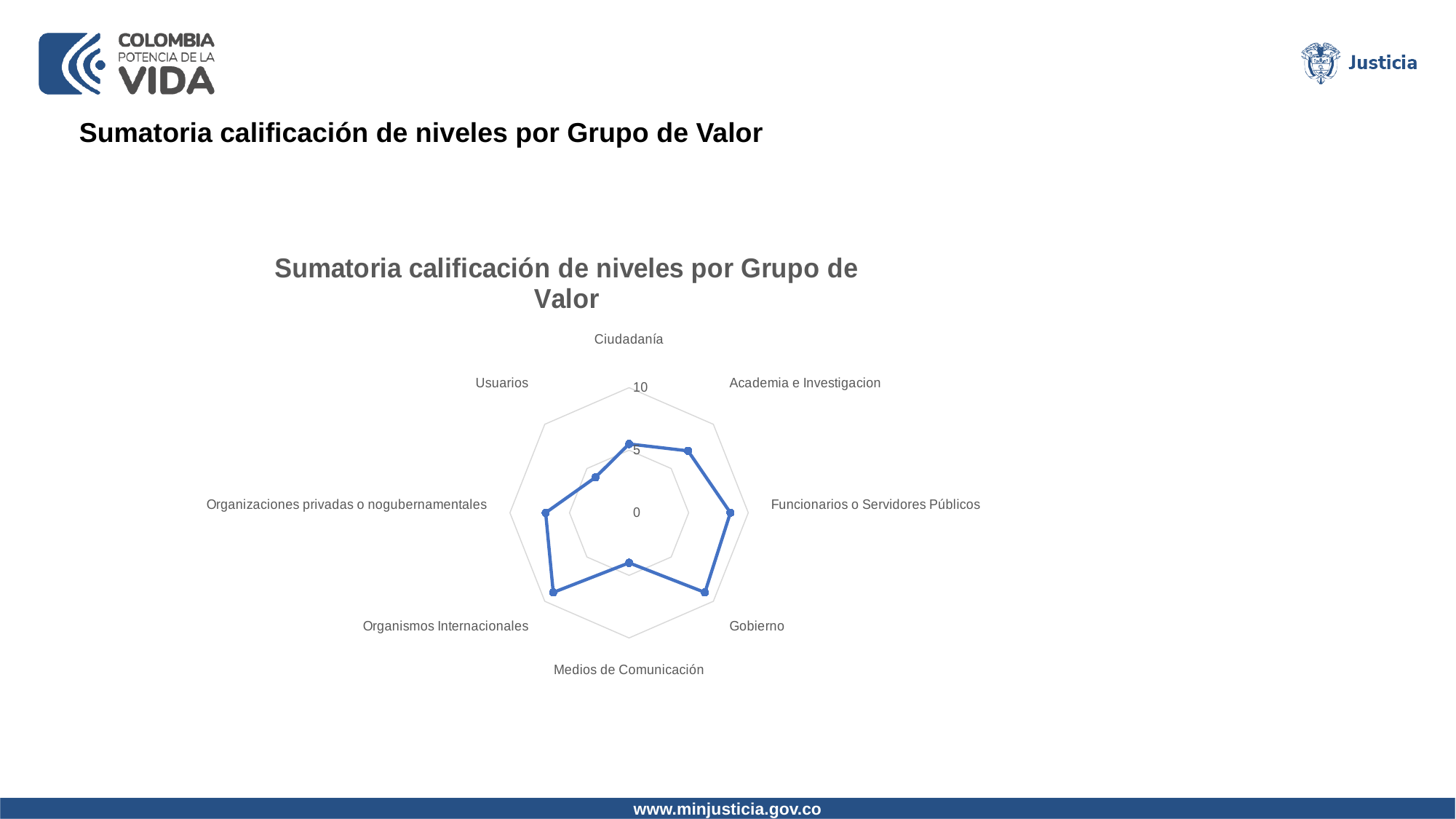
Is the value for Medios de Comunicación greater or less than 5? less Which has the larger value, Organismos Internacionales or Medios de Comunicación? Organismos Internacionales Is the value for Gobierno greater or less than 5? greater Is the value for Usuarios greater or less than 5? less What is the highest value shown on the chart's axis scale? 10 What is the title of the chart? Sumatoria calificación de niveles por Grupo de Valor What kind of chart is shown on the slide? Radar chart Which has the larger value, Funcionarios o Servidores Públicos or Usuarios? Funcionarios o Servidores Públicos How many categories (groups) are plotted on the radar chart? 8